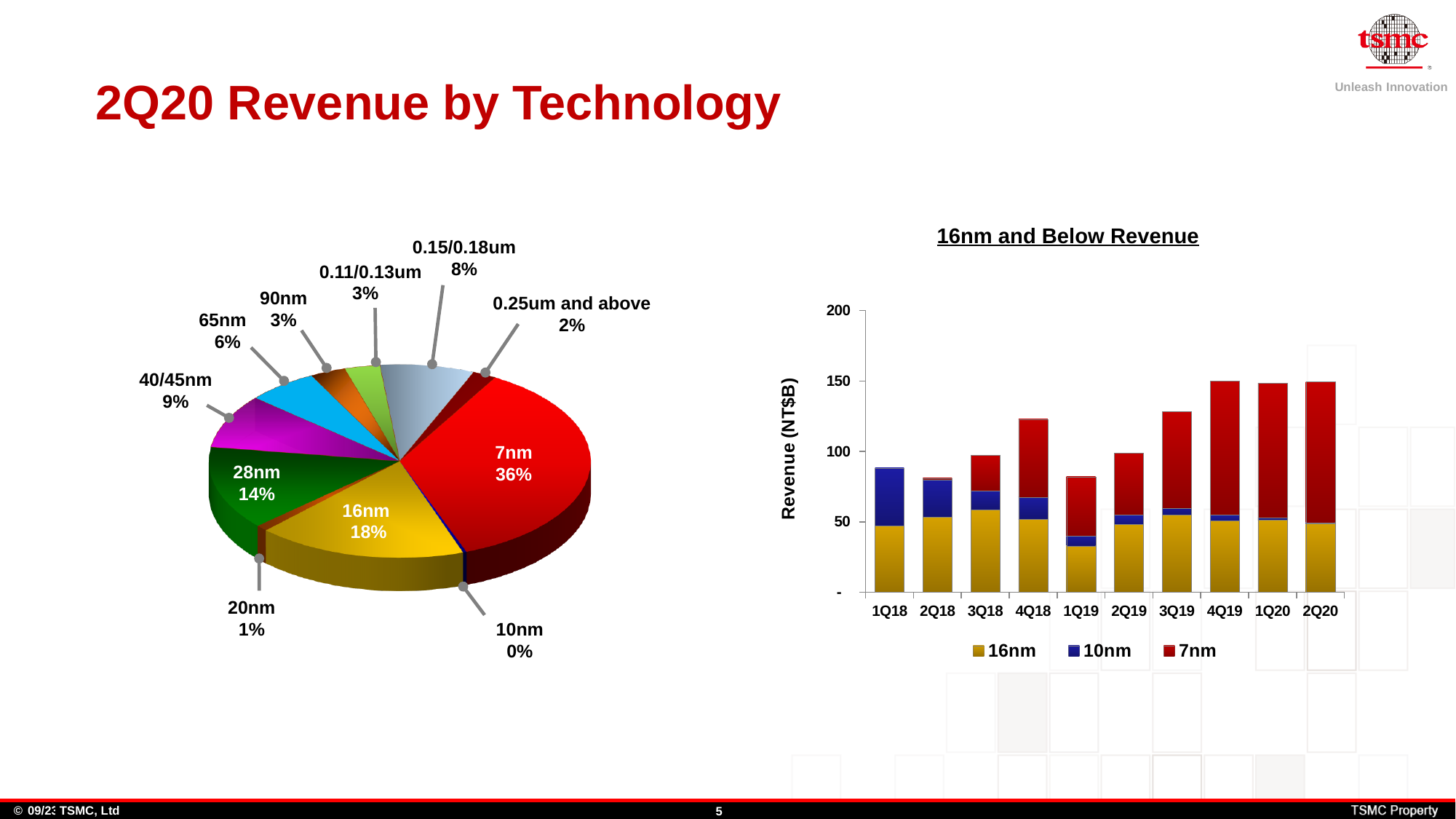
In the pie chart, which has a larger share of 2Q20 revenue, 40/45nm or 65nm? 40/45nm In the pie chart, what is the difference in percentage points between the 7nm share and the 16nm share? 18 In the pie chart, what share of 2Q20 revenue comes from 0.15/0.18um? 8% In the 16nm and Below Revenue chart, how many quarters are shown on the x axis? 10 In the pie chart, what share of 2Q20 revenue comes from 28nm? 14% In the pie chart, which technology has the smallest share of 2Q20 revenue? 10nm In the 16nm and Below Revenue chart, is the total revenue for 4Q18 greater or less than 100? greater In the 16nm and Below Revenue chart, is the total revenue for 1Q19 greater or less than 100? less In the pie chart, what share of 2Q20 revenue comes from 7nm? 36% In the pie chart, which technology has the largest share of 2Q20 revenue? 7nm In the 16nm and Below Revenue chart, how many series does the legend list? 3 In the pie chart, how many technology categories are shown? 11